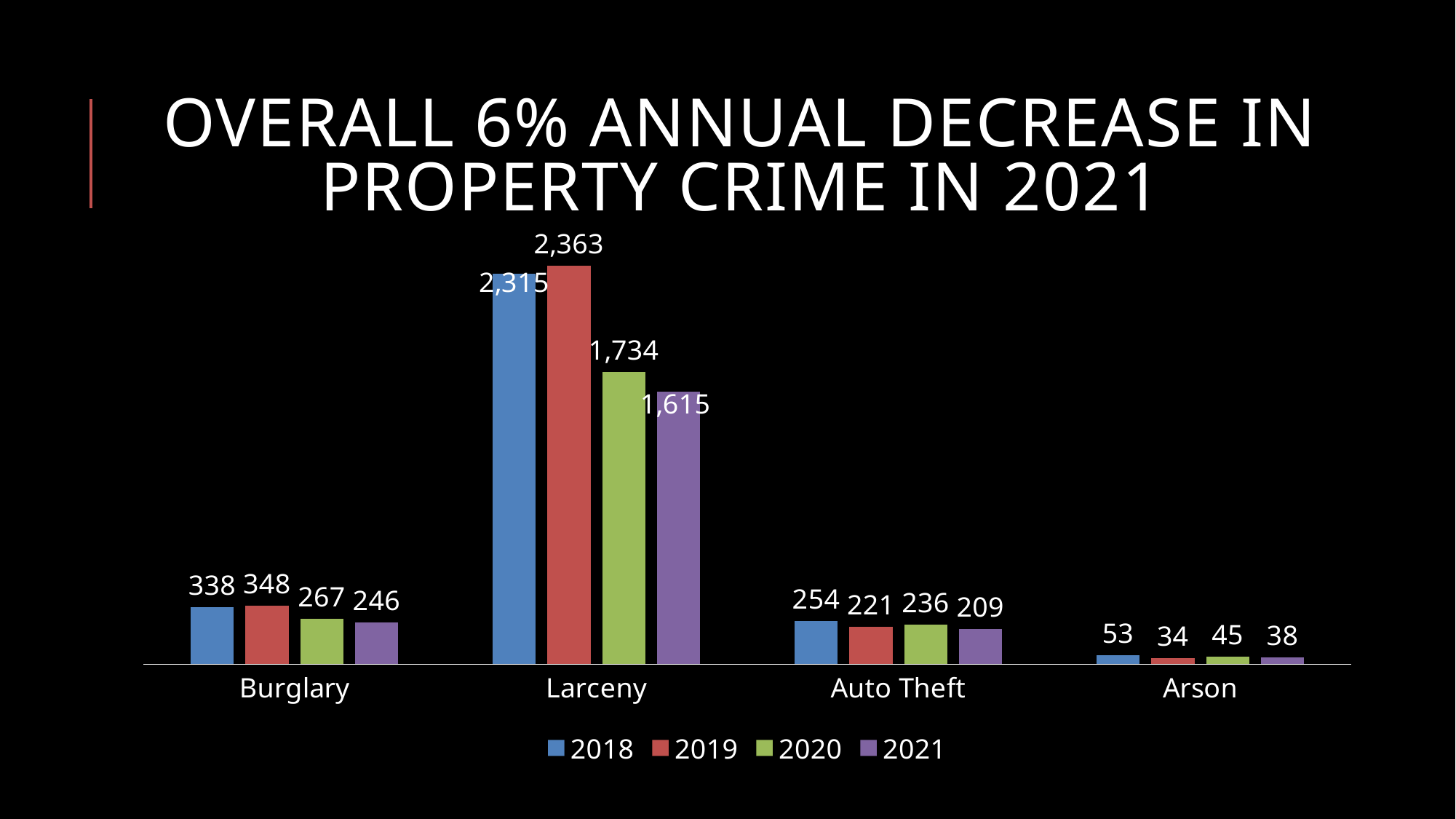
What is the value for Burglary in 2021? 246 What kind of chart is shown on the slide? Bar chart Which category has the highest value in 2021? Larceny How many categories are shown on the x axis? 4 What is the title of the slide? Overall 6% Annual Decrease in Property Crime in 2021 What is the value for Arson in 2018? 53 How many series does the legend list? 4 What is the value for Auto Theft in 2020? 236 Which category has the lowest value in 2019? Arson Which is larger, the Auto Theft value for 2018 or for 2021? 2018 What is the value for Larceny in 2019? 2,363 What is the difference between the Larceny values for 2018 and 2021? 700